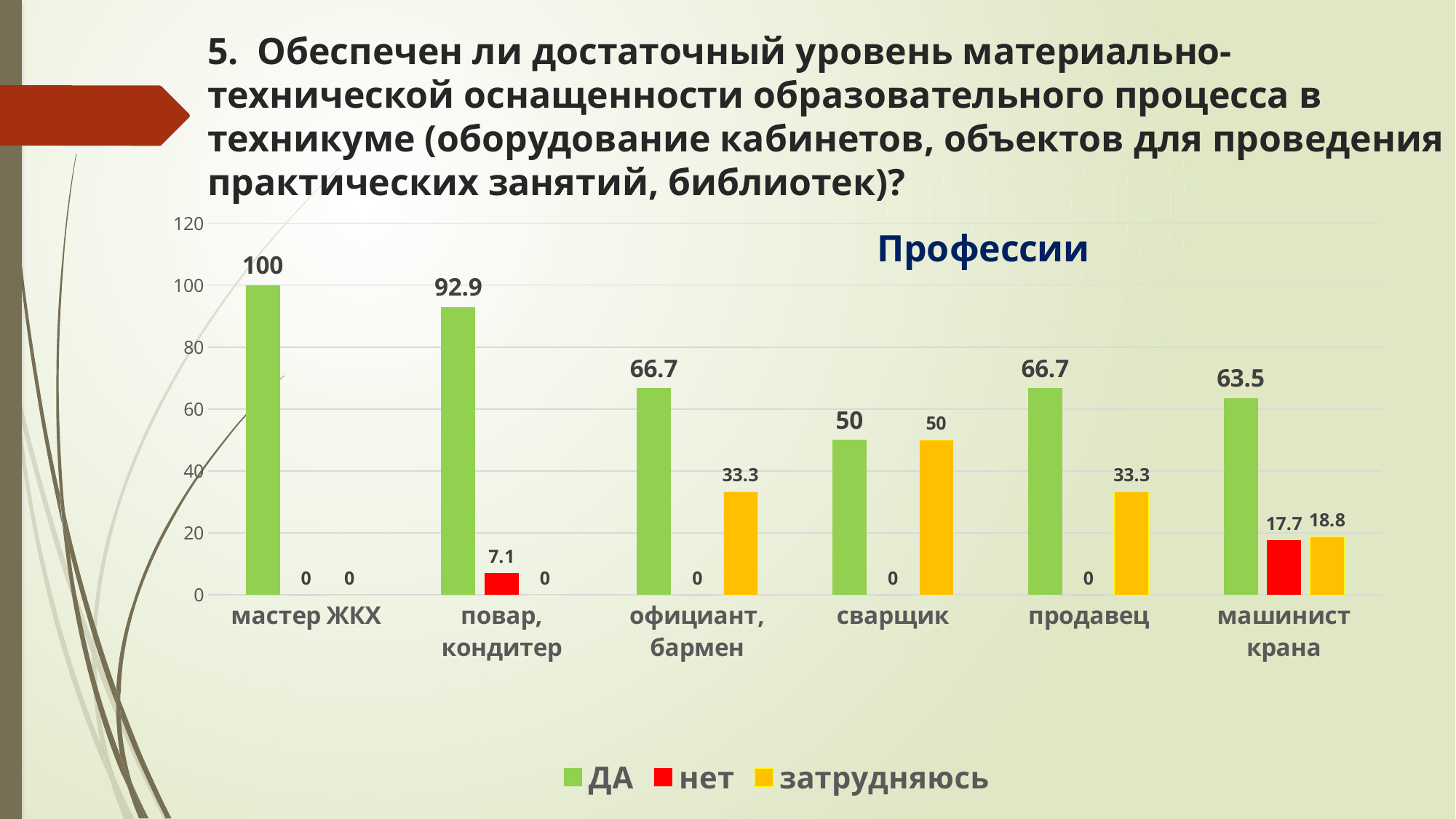
What is the value of the нет series for повар, кондитер? 7.1 What is the value of the затрудняюсь series for сварщик? 50 How many series does the legend list? 3 What type of chart is shown on the slide? bar chart Which category has the highest value in the ДА series? мастер ЖКХ How many categories are shown on the x axis? 6 Which is larger: the затрудняюсь value for официант, бармен or the затрудняюсь value for машинист крана? официант, бармен What is the difference between the ДА values for повар, кондитер and машинист крана? 29.4 Which category has the lowest value in the ДА series? сварщик What is the value of the нет series for машинист крана? 17.7 What is the title of the chart? Профессии What is the value of the ДА series for мастер ЖКХ? 100